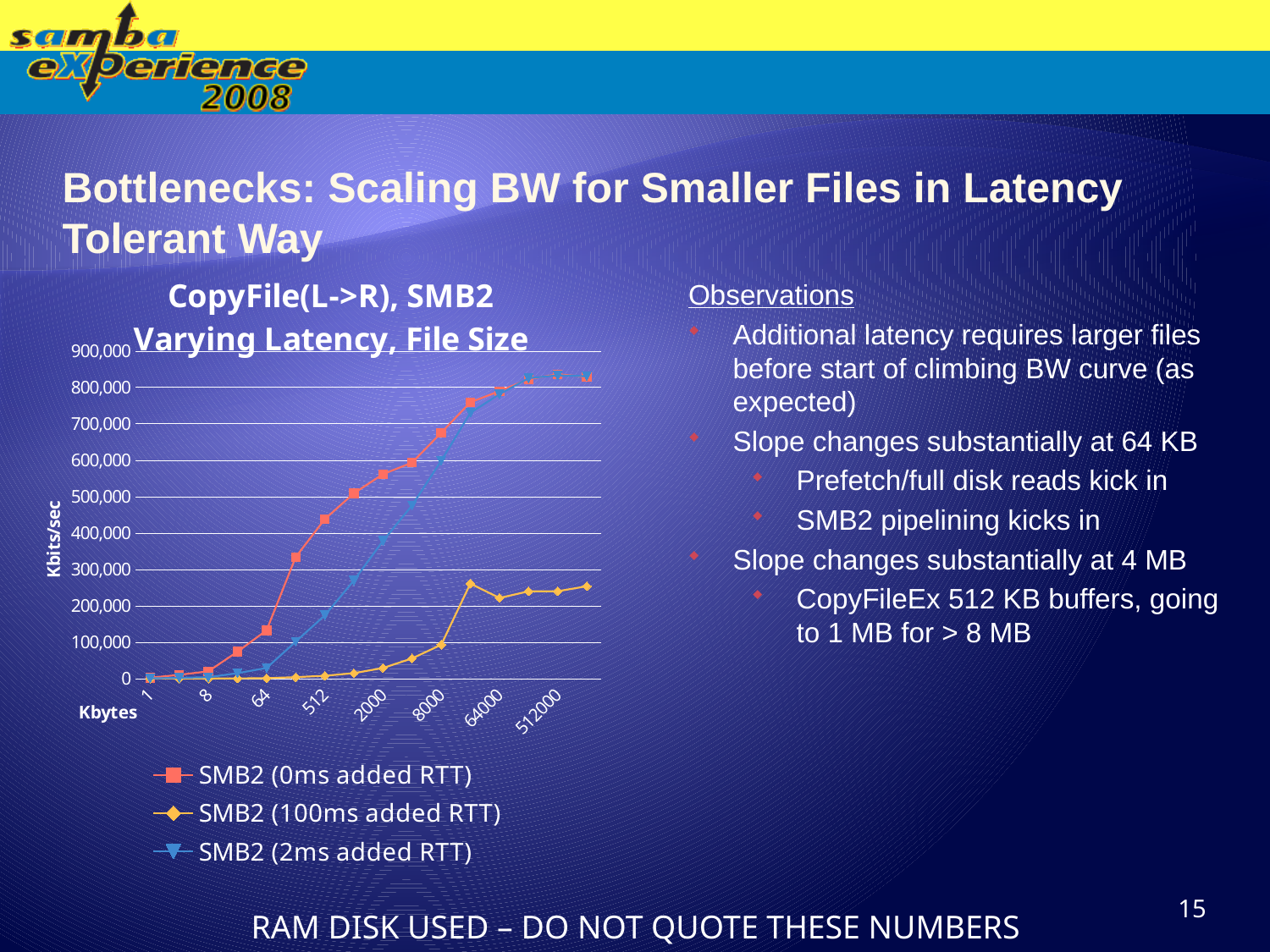
Is the value for SMB2 (100ms added RTT) at 64000 Kbytes greater or less than 200,000? greater What is the label on the horizontal axis of the chart? Kbytes At 512 Kbytes, which series has the larger value: SMB2 (0ms added RTT) or SMB2 (100ms added RTT)? SMB2 (0ms added RTT) Is the value for SMB2 (0ms added RTT) at 64 Kbytes greater or less than 100,000? greater What kind of chart is shown on the slide? line chart How many series does the chart legend list? 3 What is the label on the vertical axis of the chart? Kbits/sec Is the value for SMB2 (2ms added RTT) at 512 Kbytes greater or less than 200,000? less Which series has the lowest value at 512000 Kbytes? SMB2 (100ms added RTT) How many tick labels are shown on the horizontal axis of the chart? 8